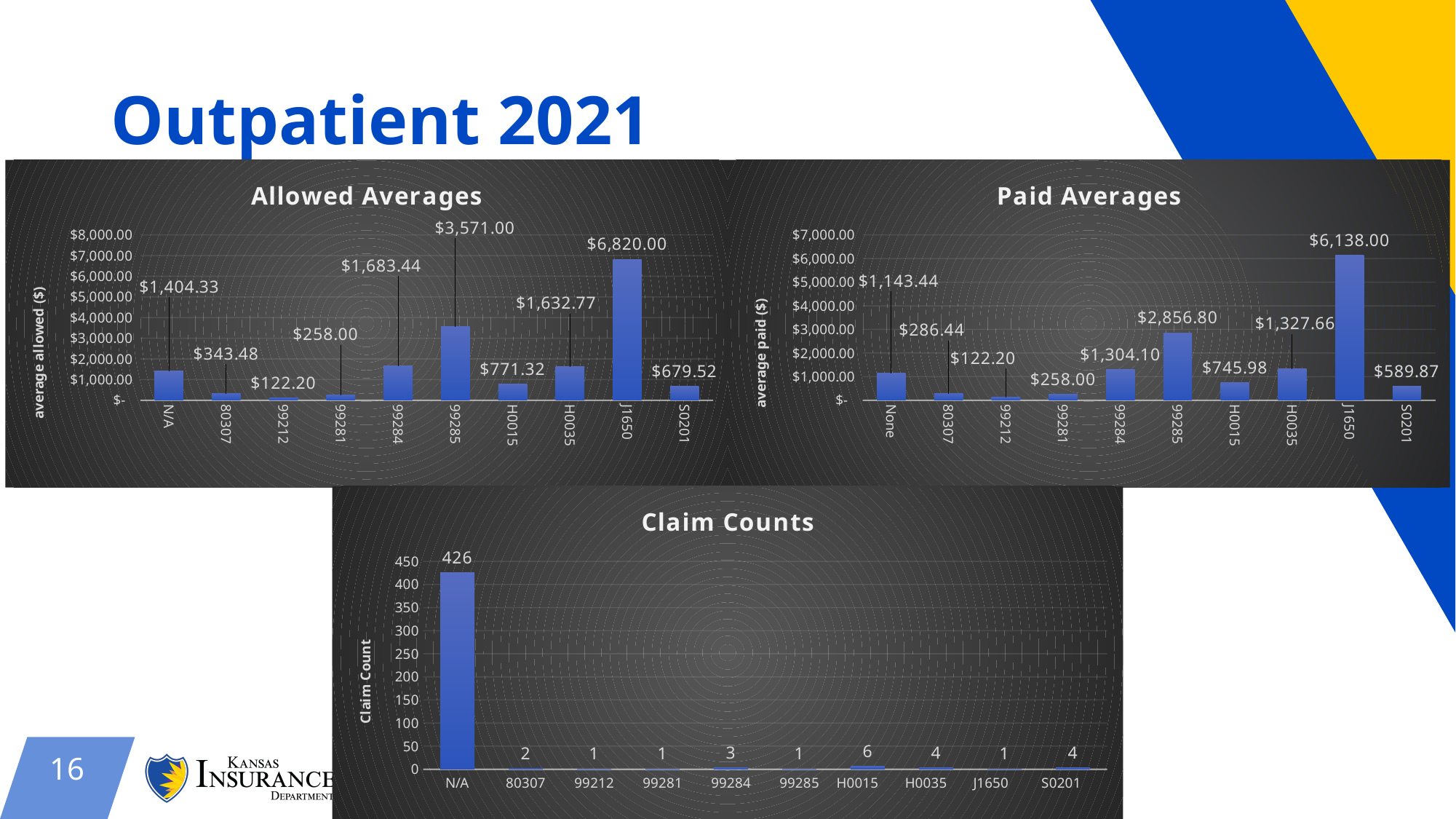
In the Paid Averages chart, how many categories are shown on the x axis? 10 In the Claim Counts chart, what is the value for N/A? 426 In the Allowed Averages chart, which category has the lowest value? 99212 In the Claim Counts chart, what is the difference between the values for N/A and H0015? 420 What kind of chart is the Claim Counts chart? Bar chart In the Claim Counts chart, what is the value for H0015? 6 What is the y-axis label of the Paid Averages chart? average paid ($) In the Paid Averages chart, which category has the highest value? J1650 In the Allowed Averages chart, what is the value for J1650? $6,820.00 In the Paid Averages chart, what is the value for H0035? $1,327.66 In the Paid Averages chart, which is larger, the value for 99284 or the value for None? 99284 In the Allowed Averages chart, what is the difference between the values for 99285 and 99284? $1,887.56